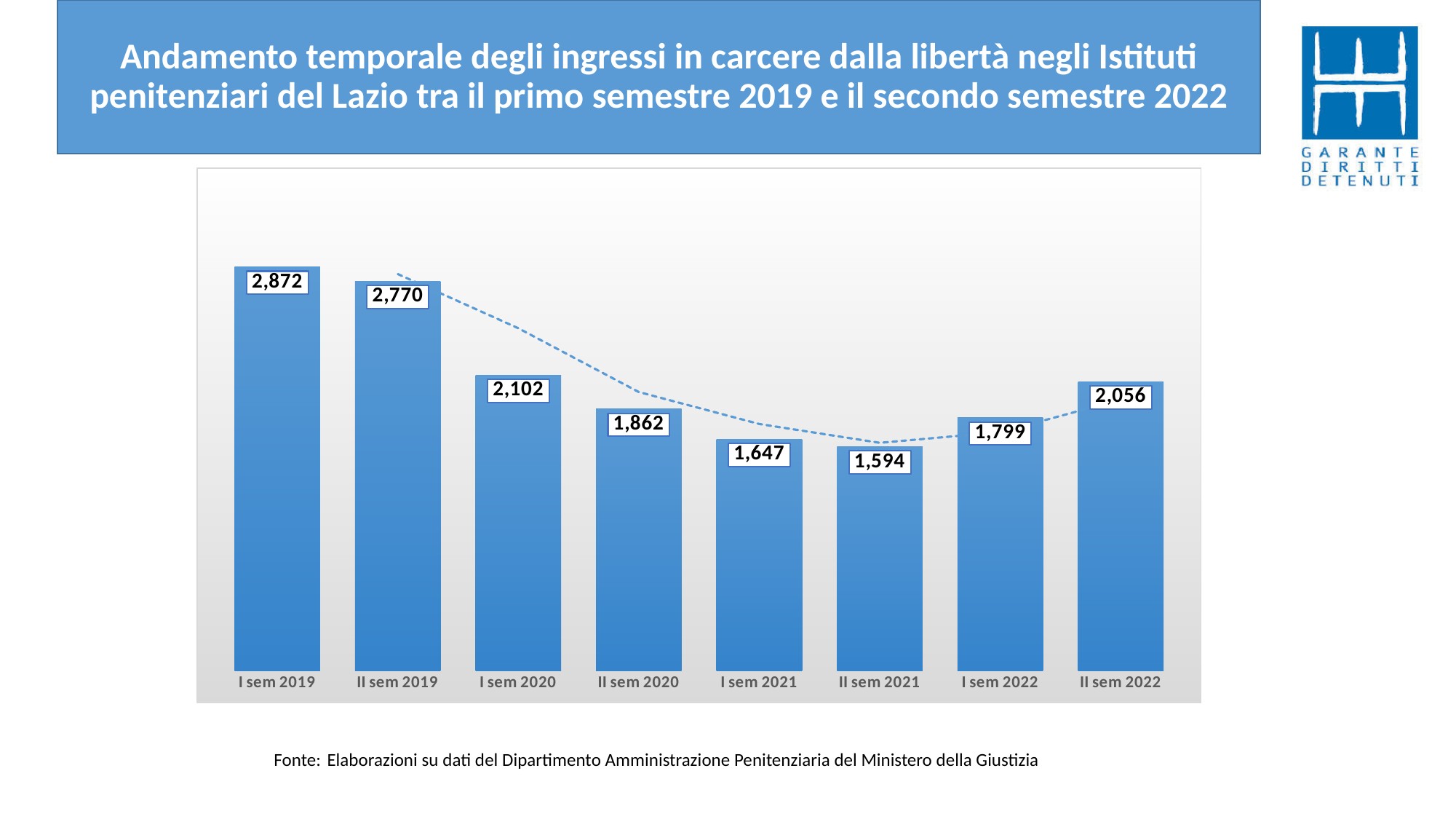
What is the value for I sem 2020? 2,102 Which semester has the lowest value? II sem 2021 What is the difference between the values for I sem 2019 and II sem 2019? 102 How many semesters are shown on the x axis? 8 What is the value for I sem 2019? 2,872 What is the value for II sem 2022? 2,056 What is the value for II sem 2021? 1,594 Which semester has the highest value? I sem 2019 What is the difference between the values for II sem 2022 and I sem 2022? 257 Which is larger, the value for I sem 2020 or the value for II sem 2022? I sem 2020 Do the values rise or fall from I sem 2019 to II sem 2021? fall What kind of chart is shown on the slide? bar chart